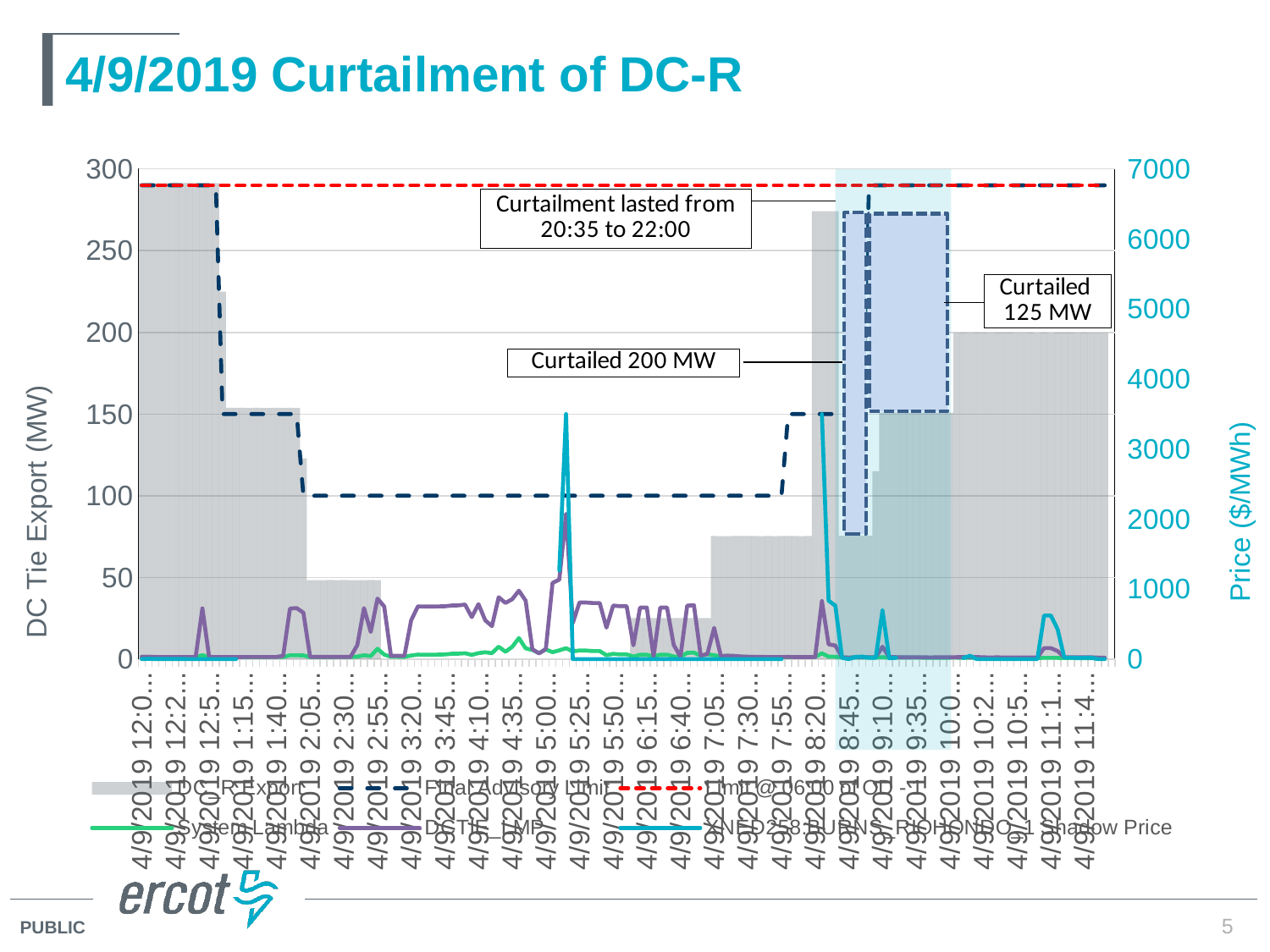
Does the Final Advisory Limit rise or fall between 4/9/2019 12:0 and 4/9/2019 3:20? fall Is the DC-R Export value at 4/9/2019 12:0 greater or less than 250? greater What is the label of the left vertical axis? DC Tie Export (MW) How many series does the legend list? 6 What is the Final Advisory Limit value at 4/9/2019 1:15? 150 According to the annotation, how much was curtailed in the second curtailment step? 125 MW According to the annotation, how much was curtailed in the first curtailment step? 200 MW According to the annotation on the chart, during what time period did the curtailment last? 20:35 to 22:00 Is the peak of the XNED258.BURNS_RIOHONDO_1 Shadow Price around 4/9/2019 5:00 greater or less than 3000 $/MWh? greater Is the DC-R Export higher at 4/9/2019 12:0 or at 4/9/2019 3:20? 4/9/2019 12:0 What is the DC-R Export value at 4/9/2019 11:4? 200 What is the Final Advisory Limit value at 4/9/2019 4:10? 100